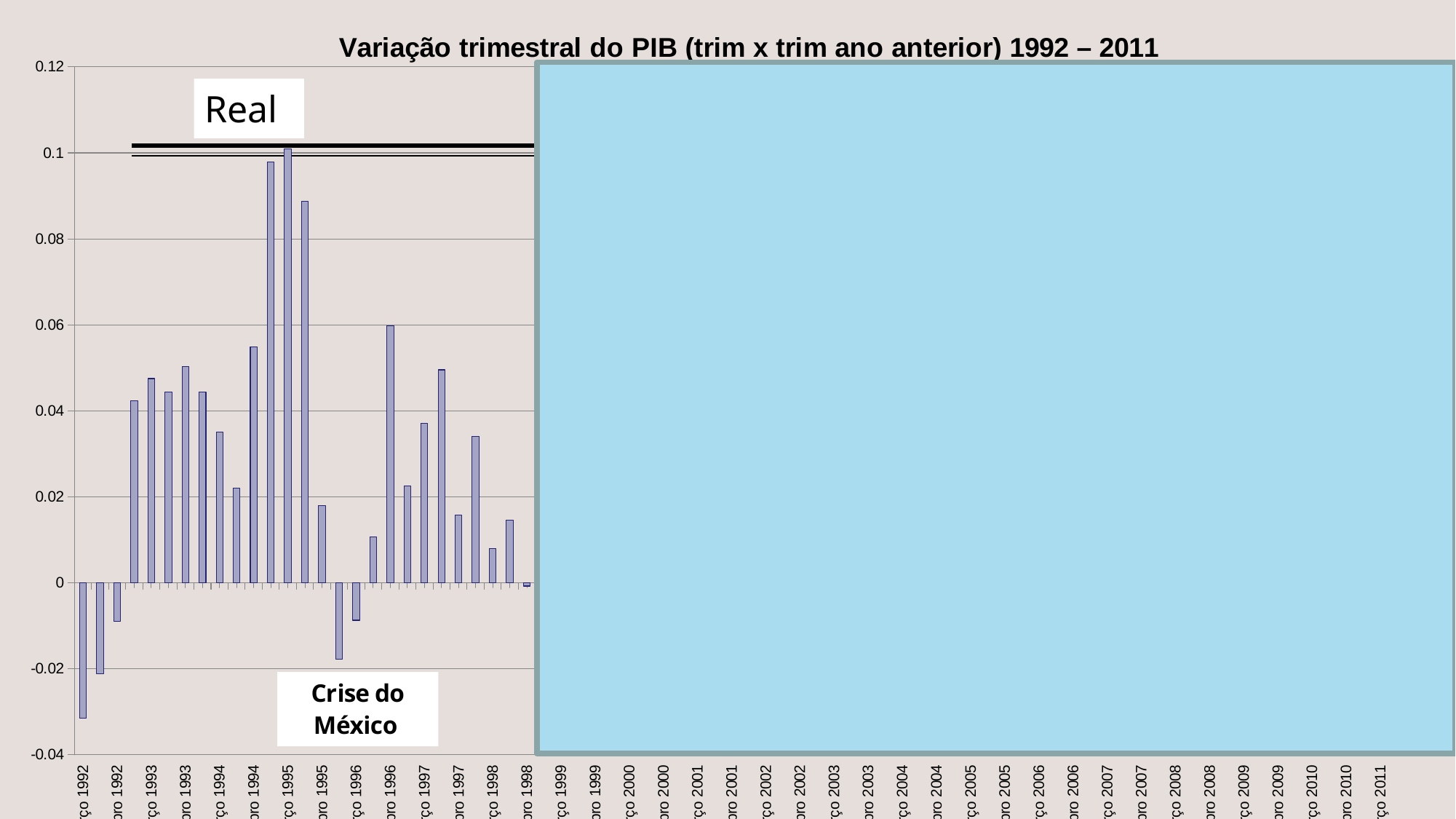
Are the first three bars on the left of the chart above or below zero? below Is the value of the tallest bar in 1996 greater or less than 0.04? greater What is the title of the chart? Variação trimestral do PIB (trim x trim ano anterior) 1992 – 2011 Which is larger: the tallest bar in 1995 or the tallest bar in 1996? The tallest bar in 1995 Is the tallest bar in the chart greater or less than 0.06? greater What kind of chart is shown on the slide? Bar chart What text is written in the annotation box near the bottom of the chart, below the negative bars around 1995–1996? Crise do México